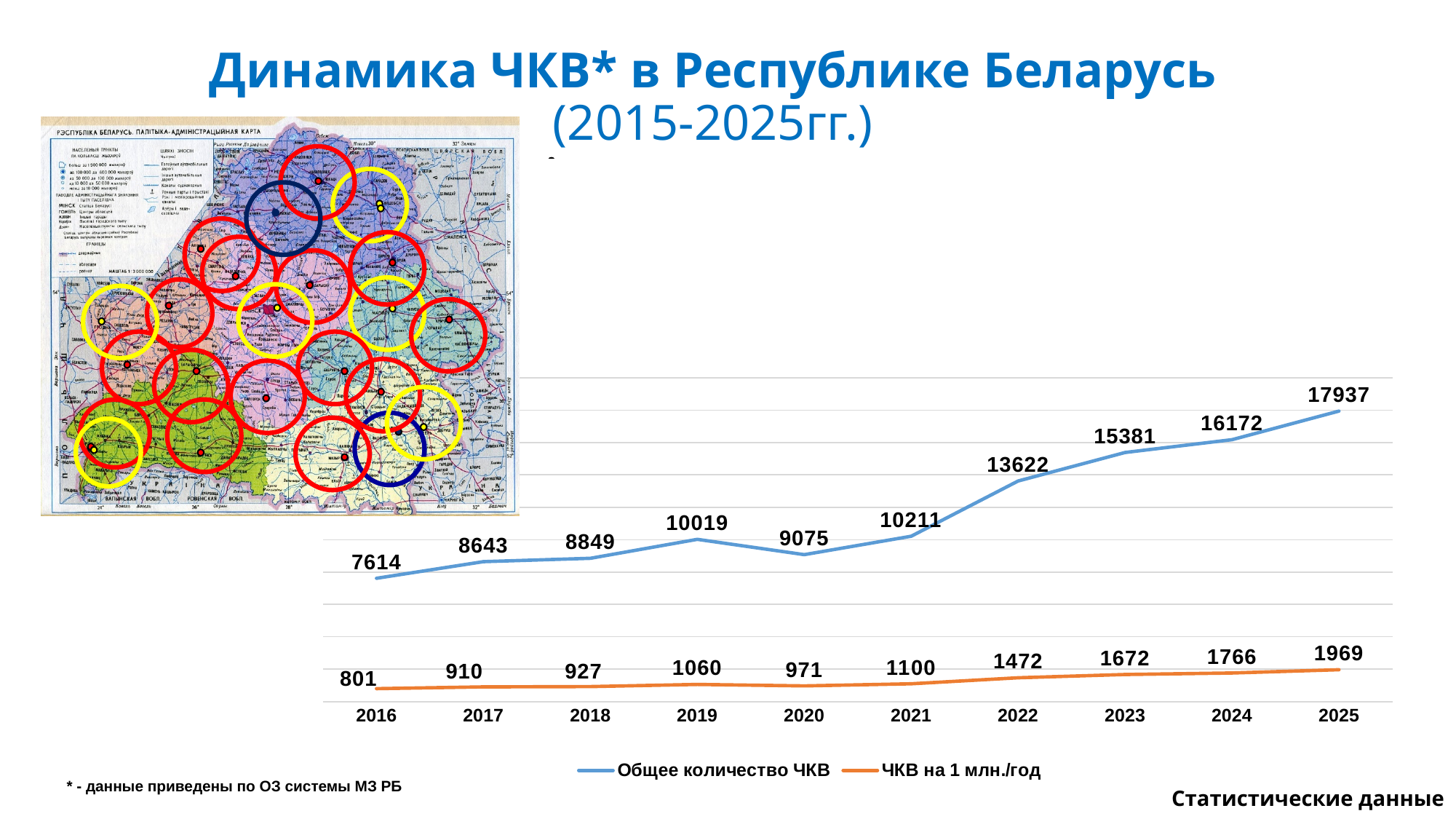
Does Общее количество ЧКВ generally rise or fall from 2016 to 2025? Rise In which year is Общее количество ЧКВ highest? 2025 What is the value of Общее количество ЧКВ in 2022? 13622 What kind of chart is shown on the slide? Line chart Which year has the larger value of Общее количество ЧКВ, 2019 or 2020? 2019 What is the difference between Общее количество ЧКВ in 2025 and in 2016? 10323 How many series does the legend list? 2 What is the value of Общее количество ЧКВ in 2016? 7614 In which year is ЧКВ на 1 млн./год lowest? 2016 How many years are shown on the x axis of the chart? 10 What is the value of ЧКВ на 1 млн./год in 2019? 1060 What is the value of ЧКВ на 1 млн./год in 2025? 1969